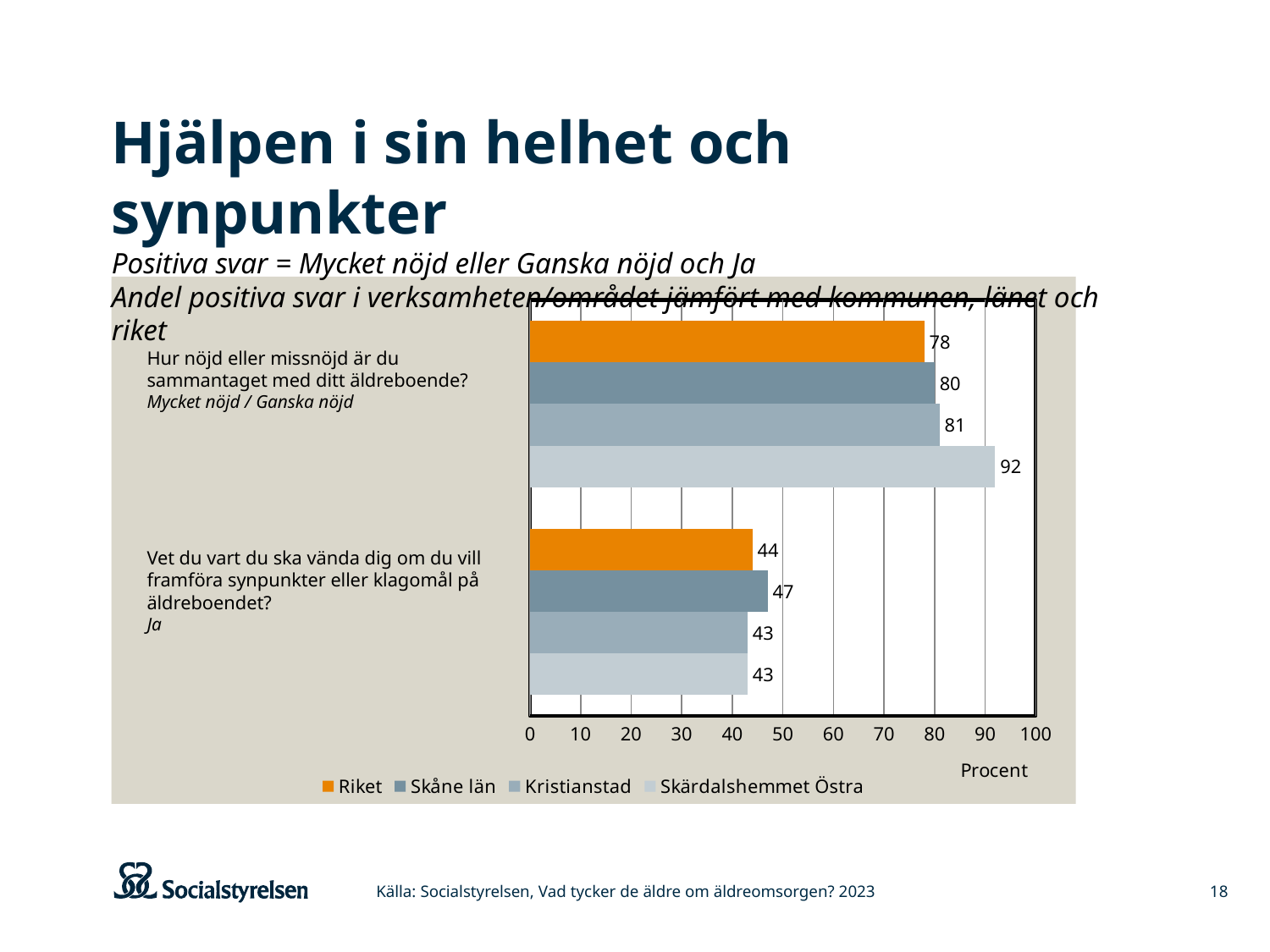
What value is shown for Riket on the question about knowing where to turn with complaints (Vet du vart du ska vända dig...)? 44 Which series has the highest value on the question about knowing where to turn with complaints? Skåne län What is the label on the x axis of the chart? Procent Which series has the highest value on the question about overall satisfaction with the elderly home? Skärdalshemmet Östra What kind of chart is shown on the slide? Bar chart How many series does the legend list? 4 Which series is shown in orange in the legend? Riket Is the value for Kristianstad higher on the overall satisfaction question or on the complaints question? Overall satisfaction question What is the difference between Skärdalshemmet Östra and Riket on the question about overall satisfaction with the elderly home? 14 Which series has the lowest value on the question about overall satisfaction with the elderly home? Riket What value is shown for Skärdalshemmet Östra on the question about overall satisfaction with the elderly home (Hur nöjd eller missnöjd är du sammantaget med ditt äldreboende)? 92 What value is shown for Skåne län on the question about overall satisfaction with the elderly home? 80